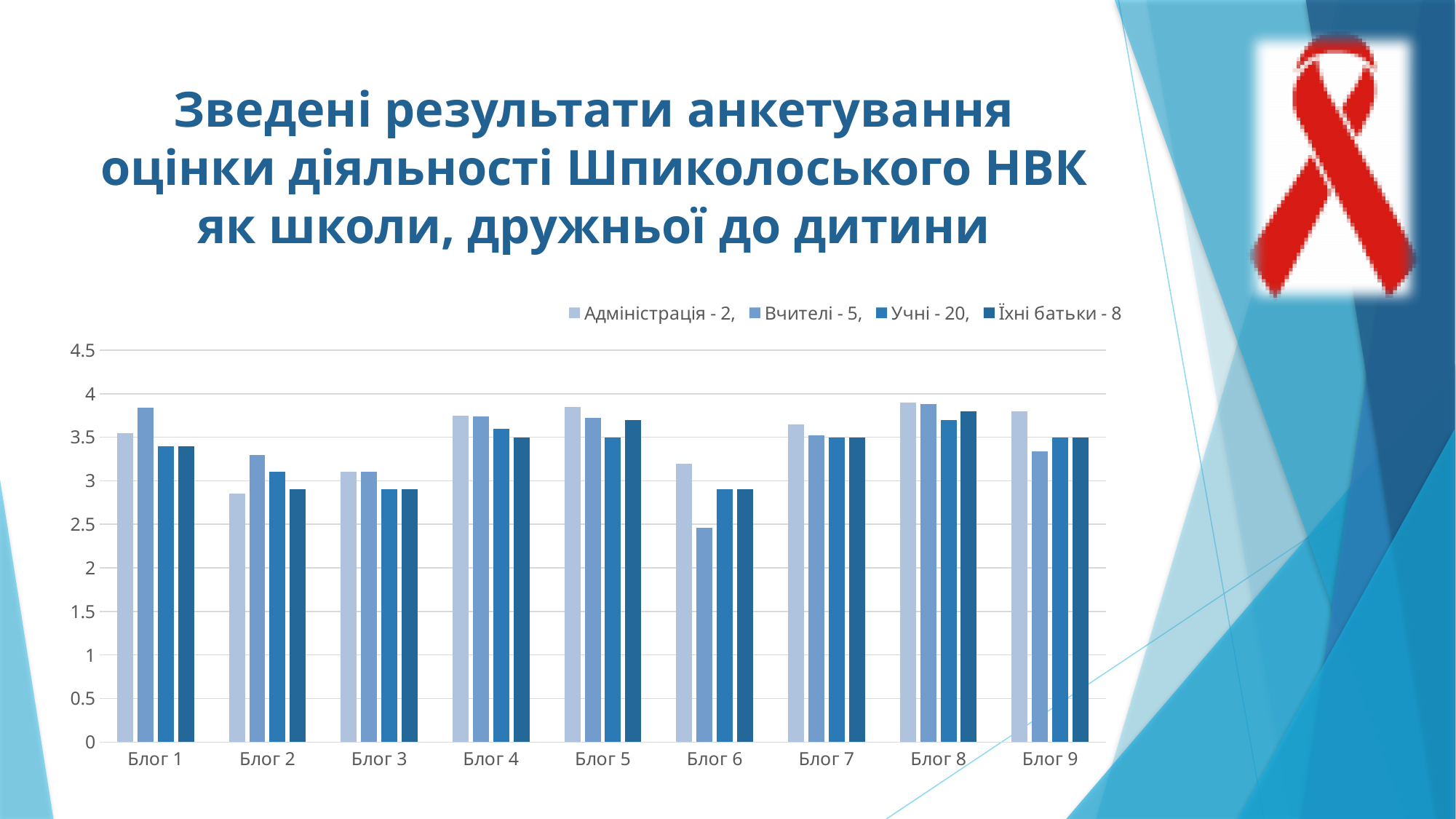
In Блог 6, which is larger: the value for Адміністрація - 2 or for Вчителі - 5? Адміністрація - 2 How many series does the legend list? 4 Which blog has the lowest value for Адміністрація - 2? Блог 2 In Блог 1, which is larger: the value for Адміністрація - 2 or for Вчителі - 5? Вчителі - 5 Is the value for Адміністрація - 2 in Блог 2 greater or less than 3? less Is the value for Вчителі - 5 in Блог 9 greater or less than 3.5? less Is the value for Вчителі - 5 in Блог 6 greater or less than 3? less Which blog has the lowest value for Вчителі - 5? Блог 6 How many categories (blogs) are shown on the x axis? 9 What kind of chart is shown on the slide? bar chart